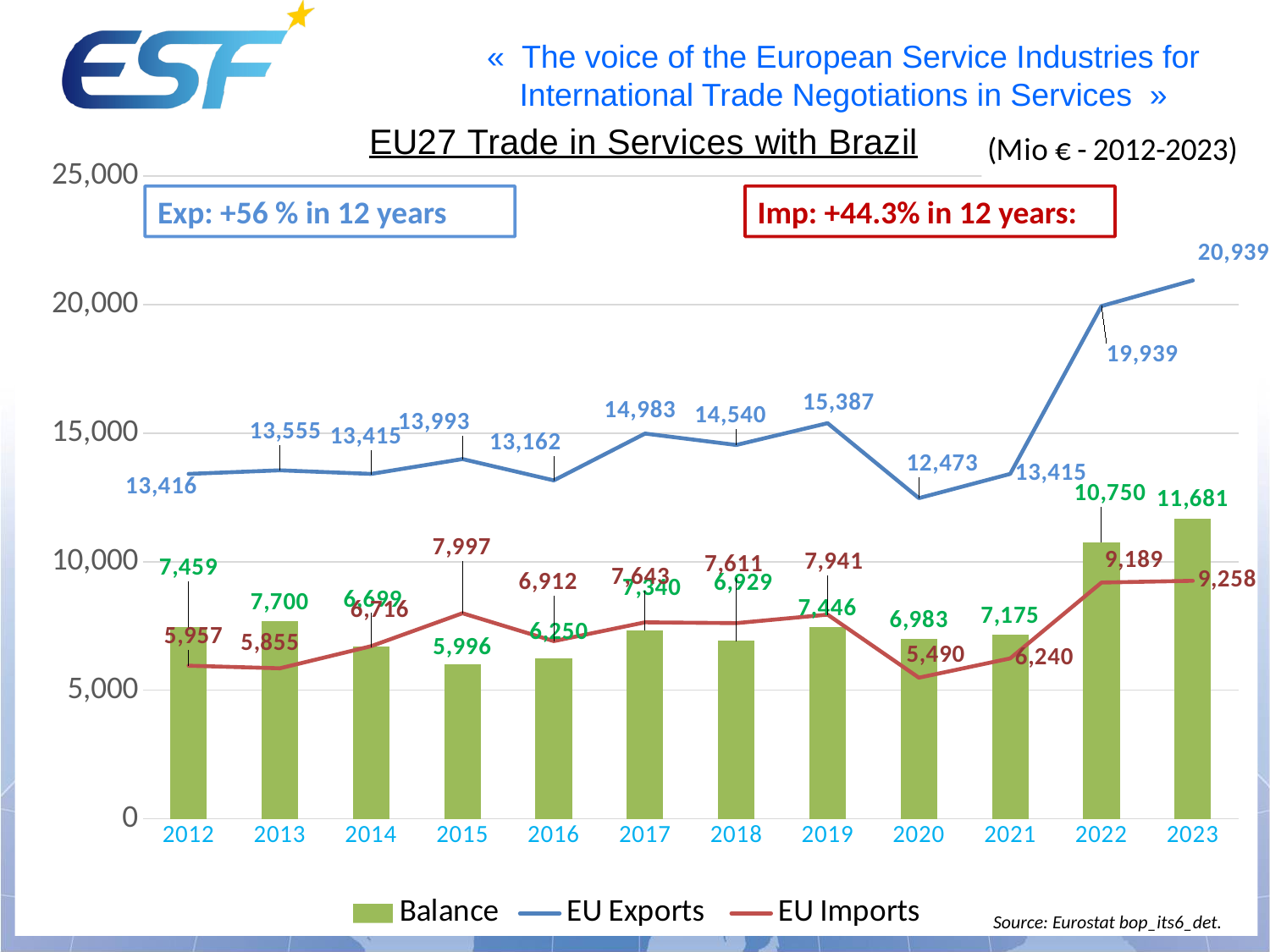
What is the title of the chart? EU27 Trade in Services with Brazil In which year were EU Exports lowest? 2020 In which year was the Balance highest? 2023 How many series does the legend list? 3 How many years are shown on the x axis? 12 In which year were EU Imports lowest? 2020 What was the Balance in 2020? 6,983 Did EU Exports rise or fall from 2021 to 2023? rise What was the value of EU Imports in 2015? 7,997 Which was larger in 2019: EU Exports or EU Imports? EU Exports What is the difference between EU Exports and EU Imports in 2022? 10,750 What was the value of EU Exports in 2023? 20,939